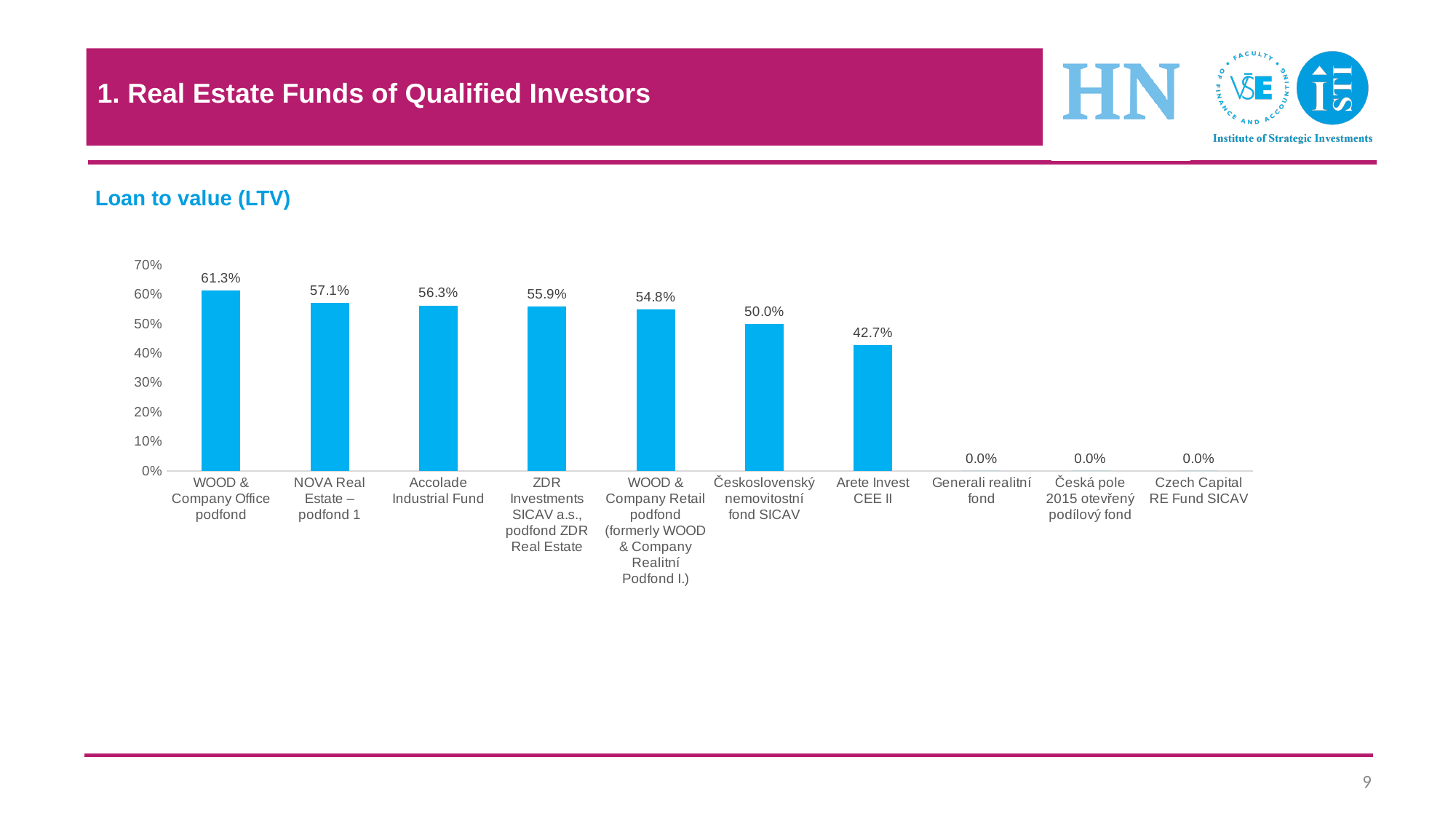
Is the LTV for Arete Invest CEE II greater or less than 50%? less Which fund has the highest loan to value (LTV)? WOOD & Company Office podfond What is the loan to value (LTV) for WOOD & Company Office podfond? 61.3% What is the difference in LTV between Accolade Industrial Fund and Arete Invest CEE II? 13.6% What is the LTV value for Československý nemovitostní fond SICAV? 50.0% Do the LTV values rise or fall from left to right along the x axis? Fall Which has a higher LTV: ZDR Investments SICAV a.s., podfond ZDR Real Estate or Arete Invest CEE II? ZDR Investments SICAV a.s., podfond ZDR Real Estate What kind of chart is used to show loan to value (LTV)? Bar chart How many funds are shown on the x axis of the chart? 10 How many funds have an LTV of 0.0%? 3 What is the difference in LTV between WOOD & Company Office podfond and NOVA Real Estate – podfond 1? 4.2% What is the LTV value shown for Arete Invest CEE II? 42.7%